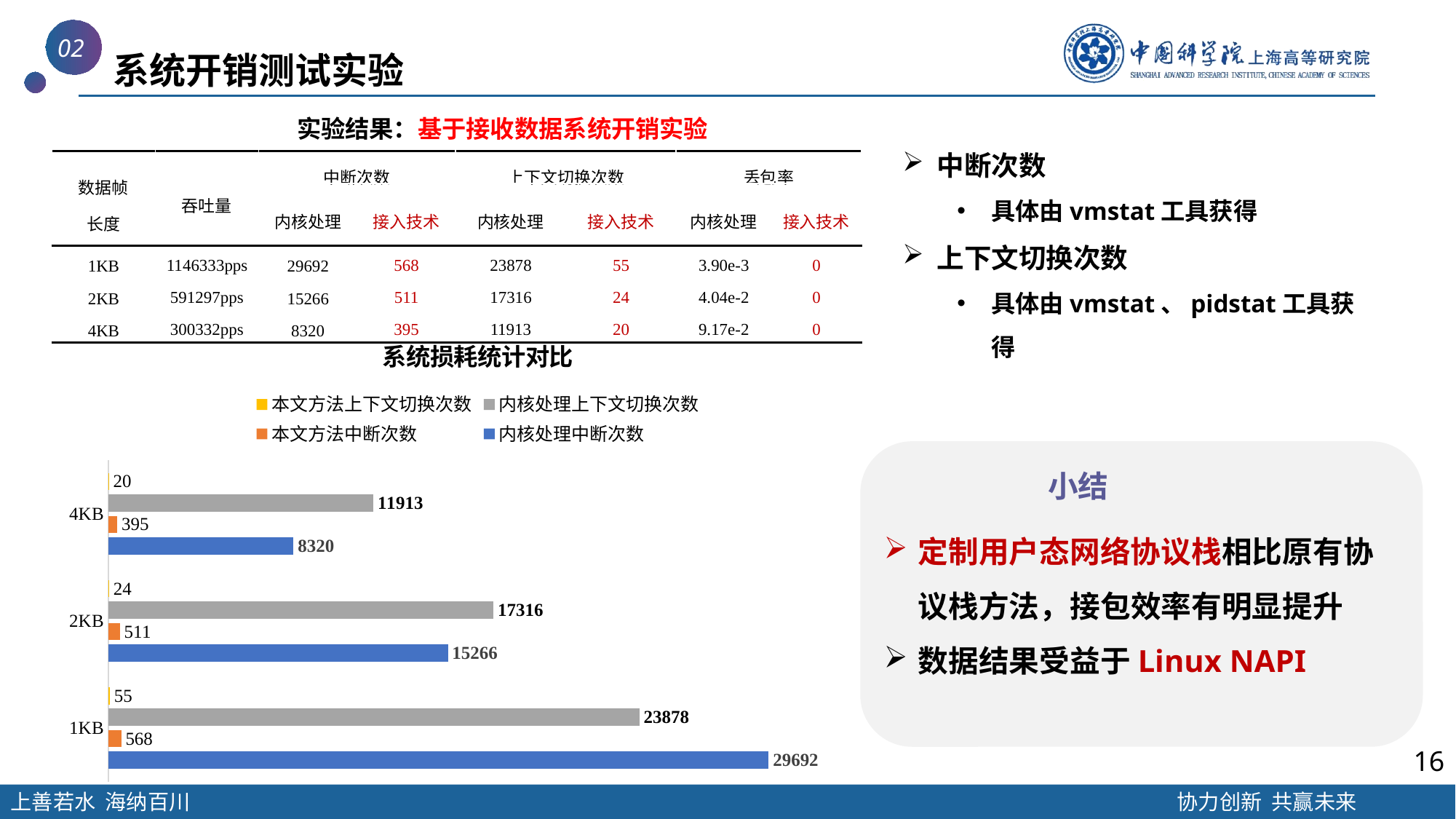
In the chart 系统损耗统计对比, which frame length has the lowest 本文方法上下文切换次数? 4KB How many frame length categories are shown in the chart 系统损耗统计对比? 3 In the chart 系统损耗统计对比, what is the difference between 内核处理中断次数 and 本文方法中断次数 for 2KB? 14755 In the chart 系统损耗统计对比, what is the value of 内核处理上下文切换次数 for 2KB? 17316 In the chart 系统损耗统计对比, what is the value of 本文方法中断次数 for 4KB? 395 In the chart 系统损耗统计对比, what is the value of 内核处理中断次数 for 1KB? 29692 How many series does the legend of the chart 系统损耗统计对比 list? 4 In the chart 系统损耗统计对比, which frame length has the highest 内核处理中断次数? 1KB In the chart 系统损耗统计对比, which is larger for 4KB: 内核处理上下文切换次数 or 内核处理中断次数? 内核处理上下文切换次数 What type of chart is 系统损耗统计对比? Bar chart In the chart 系统损耗统计对比, what is the value of 本文方法上下文切换次数 for 1KB? 55 In the chart 系统损耗统计对比, which colour represents 内核处理中断次数? Blue